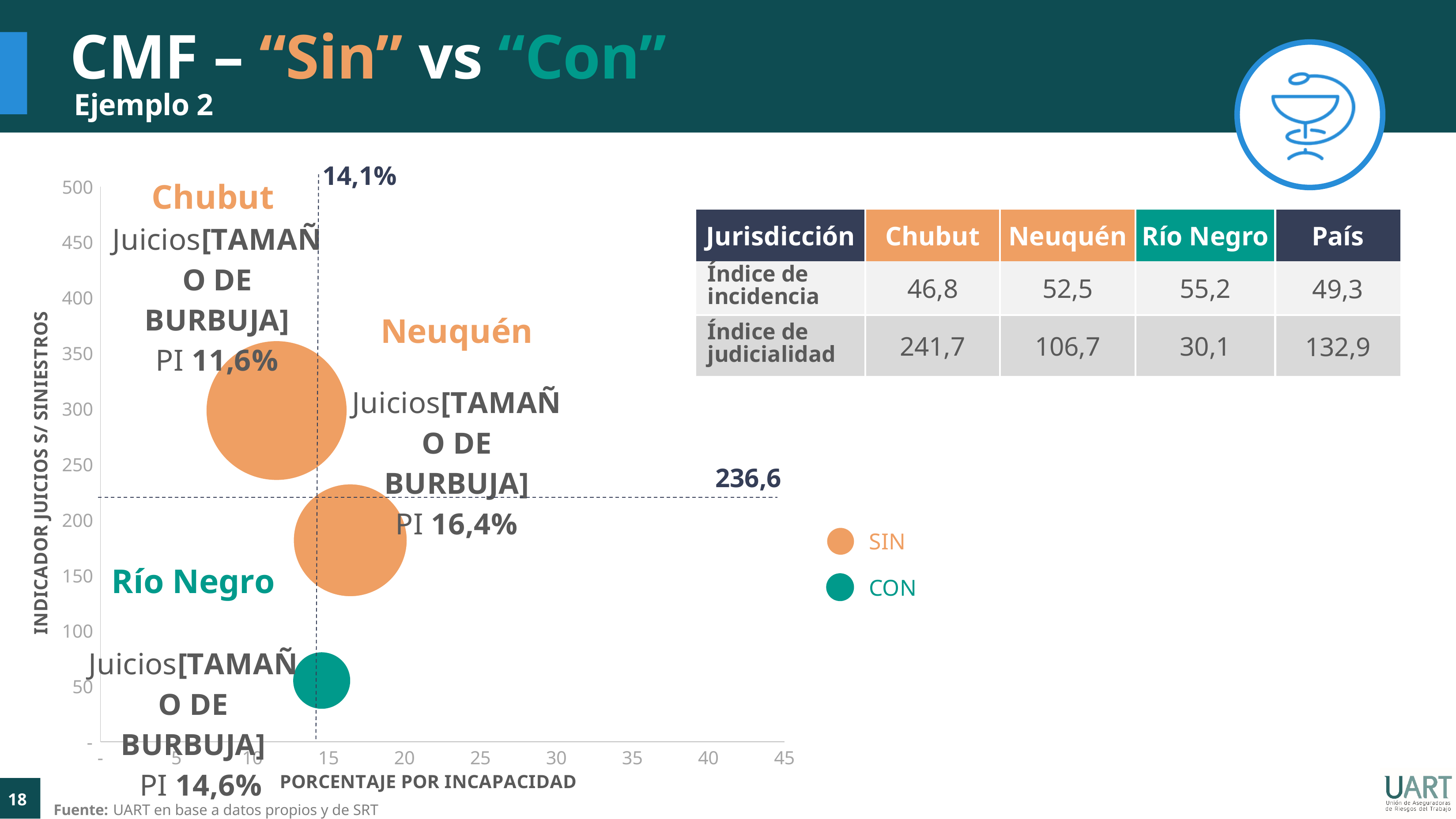
Is the value on the 'Indicador juicios s/ siniestros' axis for Río Negro greater or less than 100? less What value is labelled on the vertical dashed reference line in the chart? 14,1% Which jurisdiction has the lowest PI value in the chart? Chubut What is the PI value labelled for Río Negro? 14,6% How many series does the chart legend list? 2 What kind of chart is shown on the left of the slide? bubble chart What is the PI (porcentaje por incapacidad) value labelled for Chubut? 11,6% Which jurisdiction has the highest PI value in the chart? Neuquén What is the difference between the PI values of Neuquén and Chubut? 4,8% What is the PI value labelled for Neuquén? 16,4% Is the value on the 'Indicador juicios s/ siniestros' axis for Chubut greater or less than 250? greater How many bubbles (jurisdictions) are plotted in the chart? 3